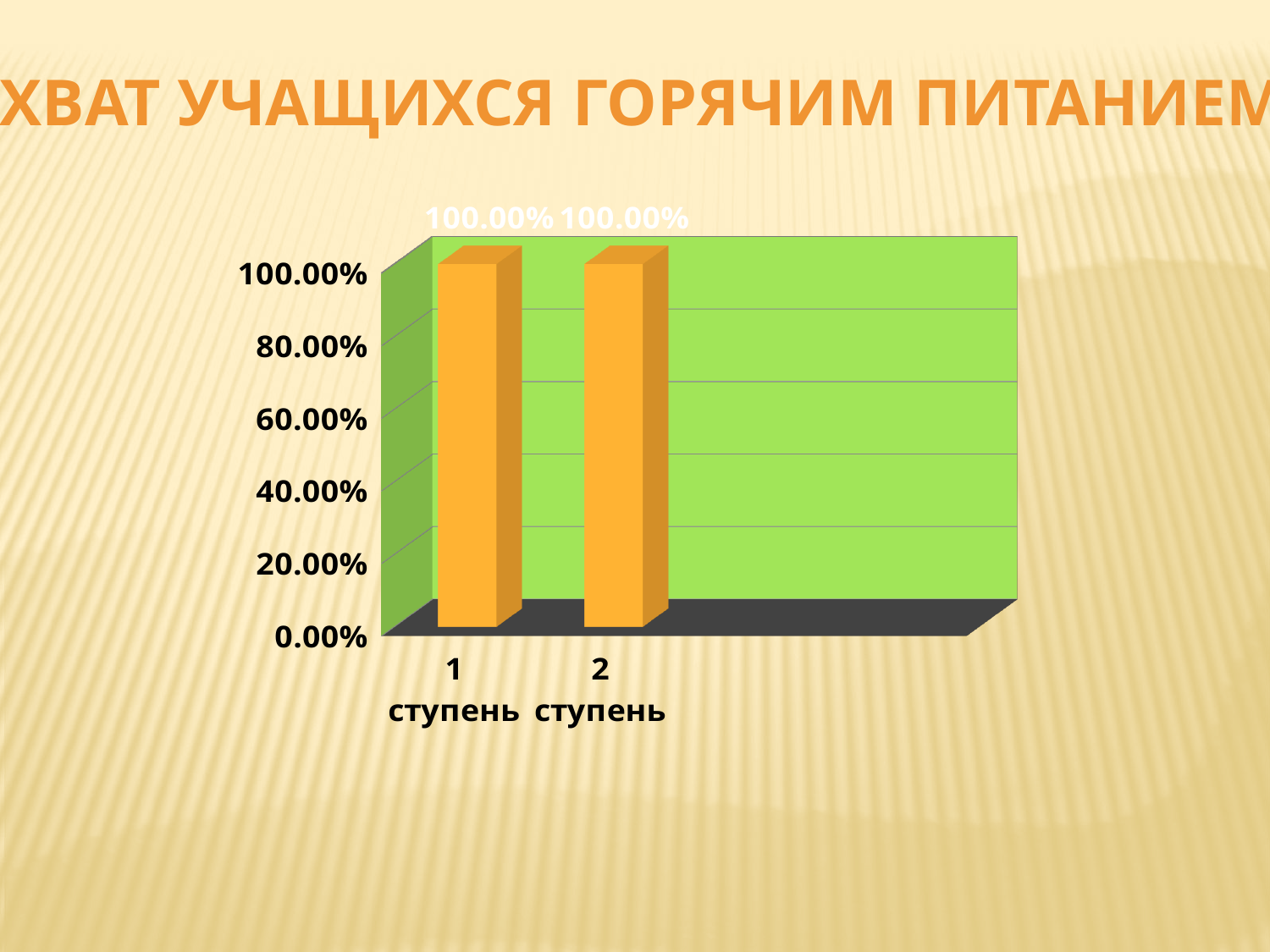
What kind of chart is shown on the slide? bar chart Is the value for 2 ступень greater or less than 80.00%? greater What is the value for 2 ступень? 100.00% What is the difference between the values for 1 ступень and 2 ступень? 0.00% What is the highest tick label shown on the vertical axis? 100.00% What is the value for 1 ступень? 100.00% How many categories are shown on the x axis? 2 Do the values rise, fall, or stay the same from 1 ступень to 2 ступень? stay the same What colour are the bars in the chart? orange Is the value for 1 ступень larger than, smaller than, or equal to the value for 2 ступень? equal